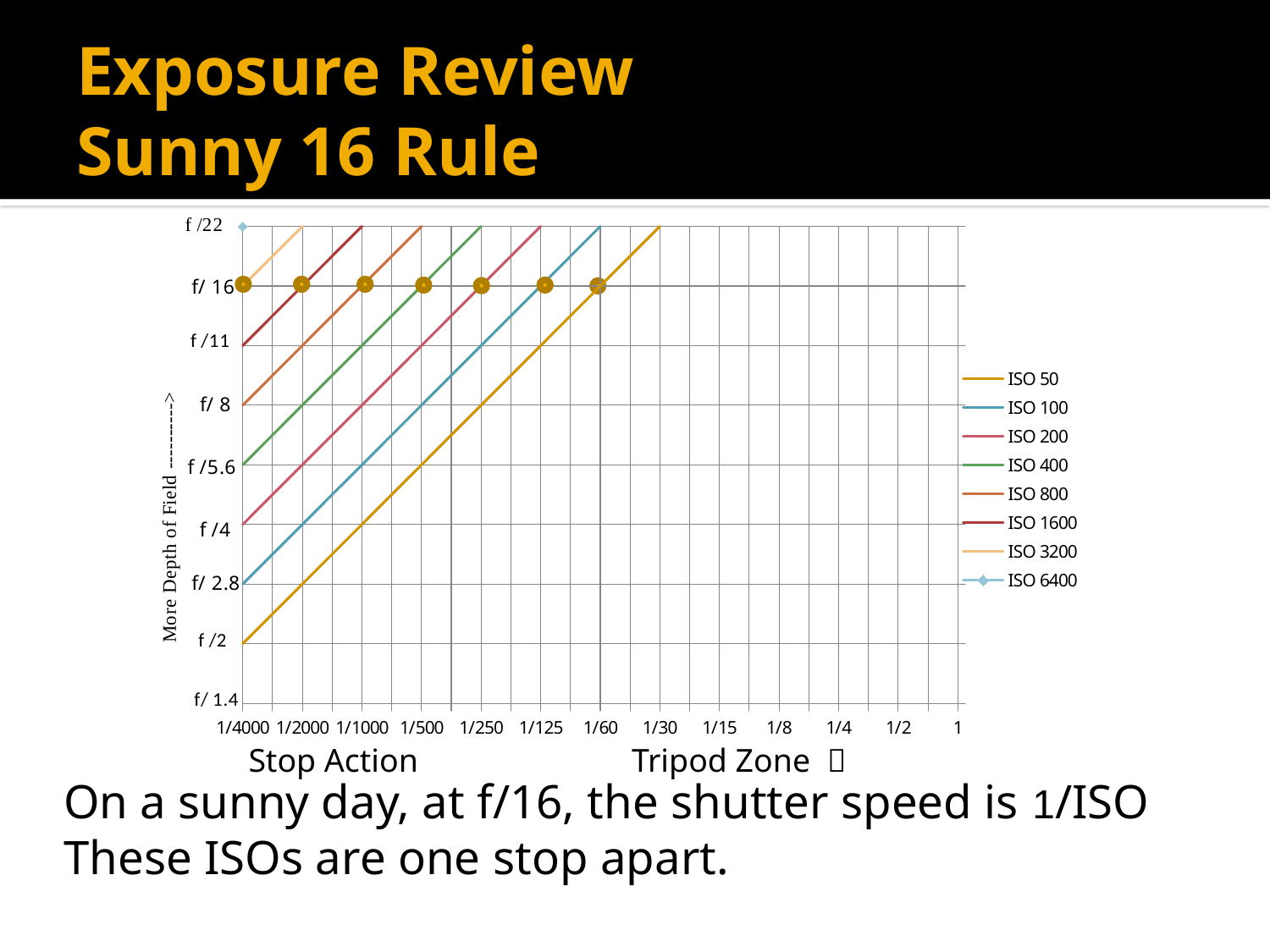
Do the ISO lines rise or fall as the shutter speed moves from 1/4000 toward 1 along the x axis? rise What kind of chart is shown on the slide? line chart At what shutter speed does the ISO 400 line reach f/16? 1/500 Which ISO series has the highest aperture value at a shutter speed of 1/4000? ISO 6400 Which ISO series has the lowest aperture value at a shutter speed of 1/4000? ISO 50 At what shutter speed does the ISO 50 line reach f/16? 1/60 How many series does the legend list? 8 What is the label on the vertical axis of the chart? More Depth of Field At a shutter speed of 1/4000, what aperture does the ISO 100 line show? f/2.8 At a shutter speed of 1/4000, what aperture does the ISO 50 line show? f/2 How many shutter speed categories are labelled along the x axis? 13 At a shutter speed of 1/250, which line is higher on the chart, ISO 200 or ISO 100? ISO 200